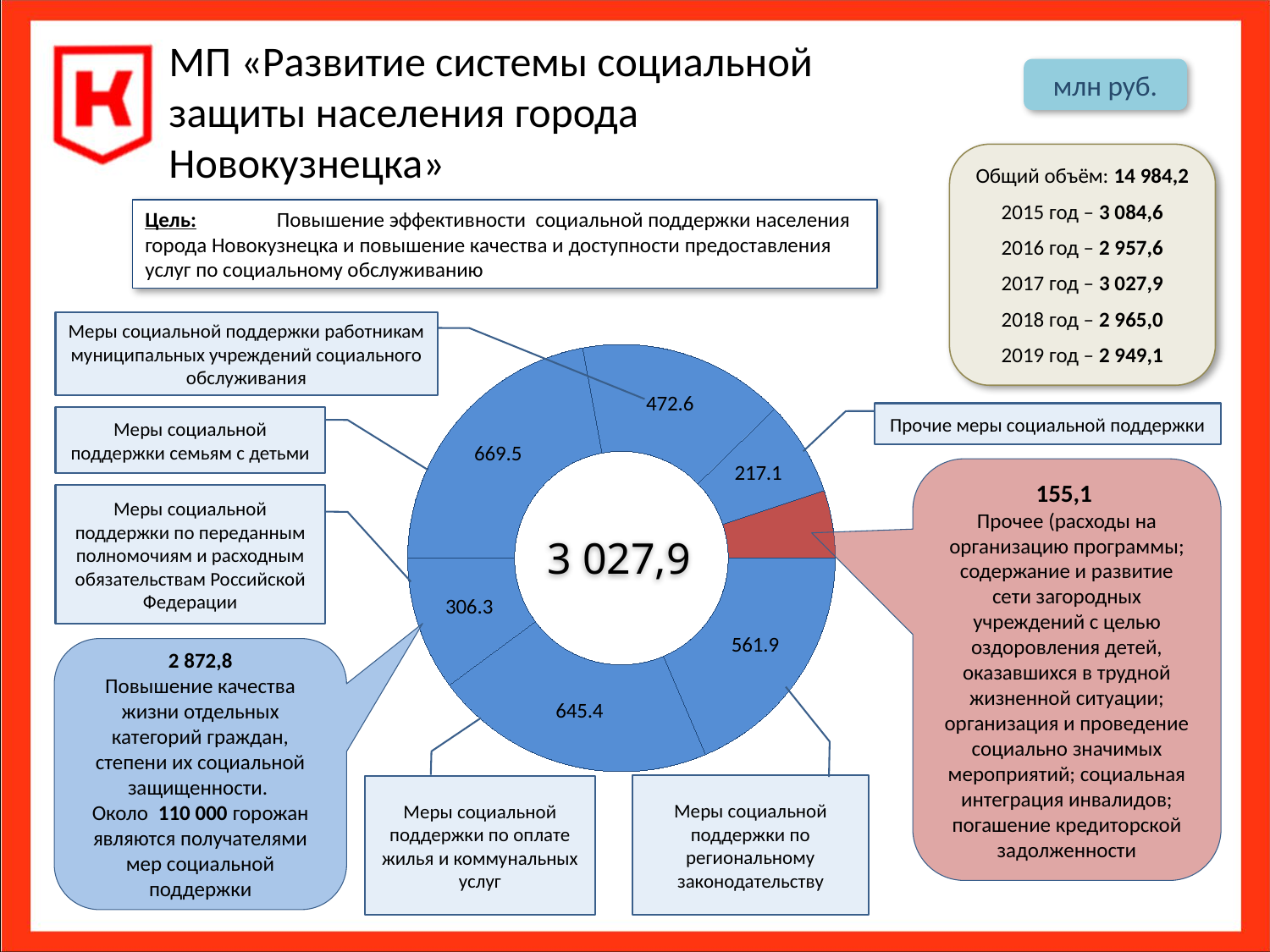
What is the value of the slice for 'Прочие меры социальной поддержки'? 217.1 What type of chart is shown on the slide? Doughnut (pie) chart Which is larger: the slice for 'Меры социальной поддержки по оплате жилья и коммунальных услуг' or the slice for 'Меры социальной поддержки по региональному законодательству'? Меры социальной поддержки по оплате жилья и коммунальных услуг How many slices does the doughnut chart have? 7 Which slice of the doughnut chart has the smallest value? Прочее (155,1) What is the value of the slice for 'Меры социальной поддержки семьям с детьми'? 669.5 What is the value of the slice for 'Меры социальной поддержки по оплате жилья и коммунальных услуг'? 645.4 What value is shown in the centre of the doughnut chart? 3 027,9 What is the value of the slice for 'Меры социальной поддержки по региональному законодательству'? 561.9 What is the difference between the slice for 'Меры социальной поддержки по региональному законодательству' (561.9) and the slice for 'Прочие меры социальной поддержки' (217.1)? 344.8 What colour is the slice for 'Прочее' (155,1) in the doughnut chart? Red Which slice of the doughnut chart has the largest value? Меры социальной поддержки семьям с детьми (669.5)